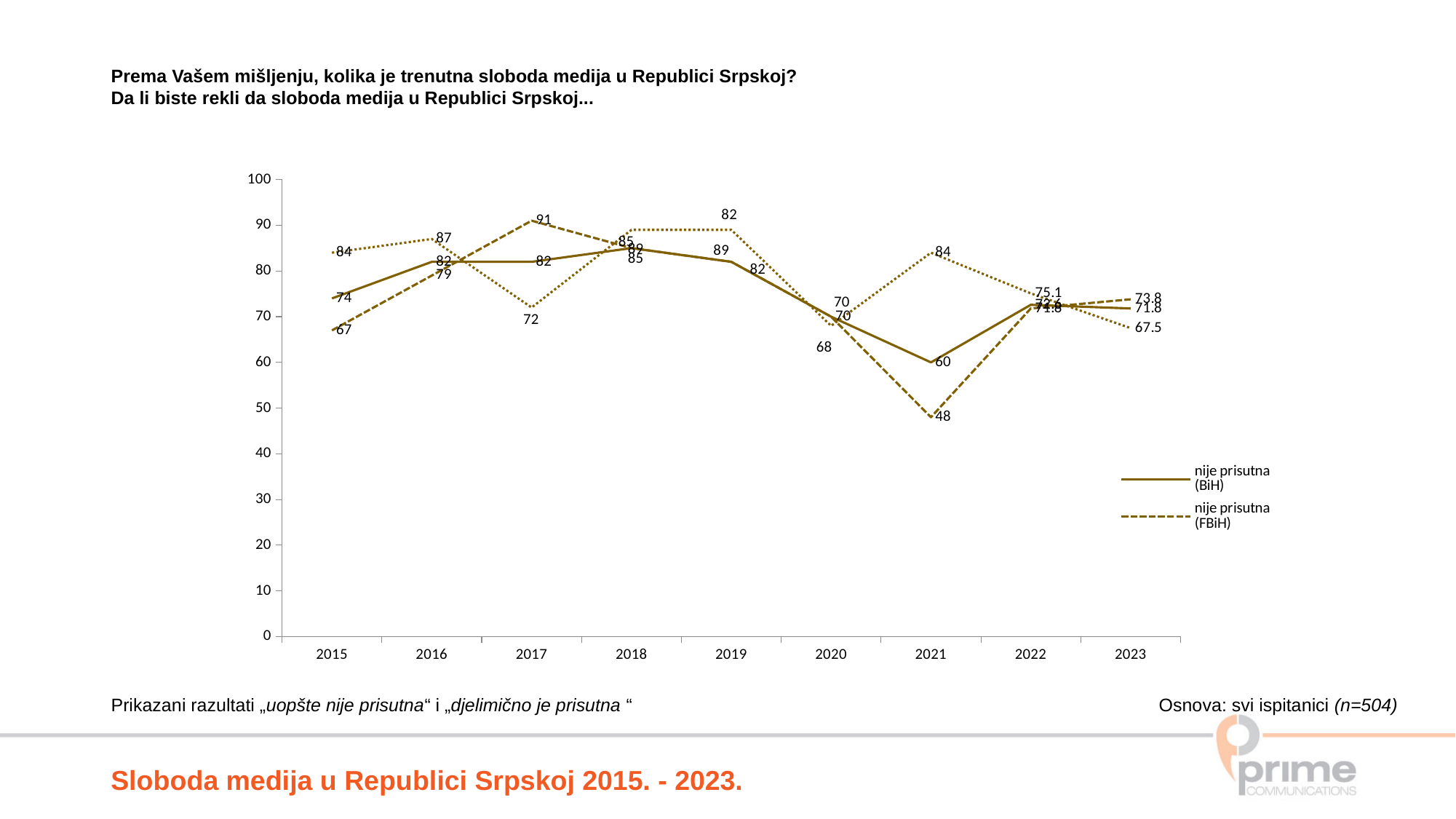
How many years are shown on the x axis? 9 What is the value for 'nije prisutna (BiH)' in 2015? 74 How many series does the legend list? 2 In which year is the 'nije prisutna (FBiH)' series at its lowest? 2021 What is the value for 'nije prisutna (FBiH)' in 2017? 91 What kind of chart is shown on the slide? line chart In which year is the 'nije prisutna (FBiH)' series at its highest? 2017 What is the value for 'nije prisutna (FBiH)' in 2021? 48 What is the difference between 'nije prisutna (BiH)' and 'nije prisutna (FBiH)' in 2021? 12 Is the value for 'nije prisutna (FBiH)' in 2021 greater or less than 50? less What is the value for 'nije prisutna (FBiH)' in 2023? 73.8 What is the value for 'nije prisutna (BiH)' in 2021? 60